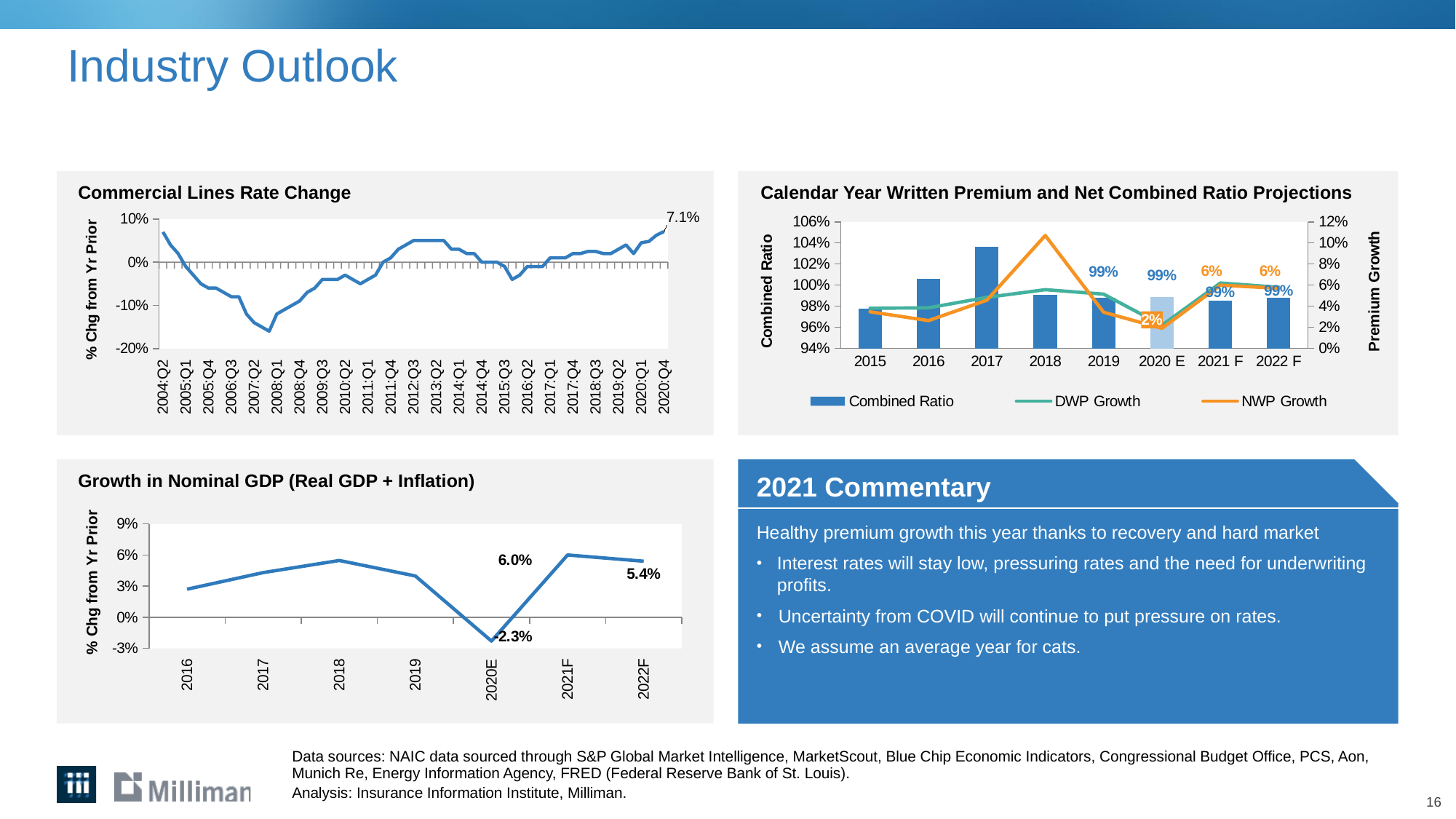
In the Growth in Nominal GDP chart, what is the value for 2020E? -2.3% How many series does the legend list in the Calendar Year Written Premium and Net Combined Ratio Projections chart? 3 In the Calendar Year Written Premium and Net Combined Ratio Projections chart, is the Combined Ratio for 2017 greater or less than 102%? greater In the Calendar Year Written Premium and Net Combined Ratio Projections chart, which year has the highest Combined Ratio bar? 2017 In the Growth in Nominal GDP chart, what is the difference between the 2021F and 2022F values? 0.6% In the Growth in Nominal GDP chart, what is the value for 2022F? 5.4% What kind of chart is the Growth in Nominal GDP (Real GDP + Inflation) chart? line chart In the Growth in Nominal GDP chart, what is the value for 2021F? 6.0% In the Calendar Year Written Premium and Net Combined Ratio Projections chart, what is the labeled NWP Growth value for 2020 E? 2% In the Growth in Nominal GDP chart, which year has the lowest value? 2020E In the Commercial Lines Rate Change chart, what is the labeled value for 2020:Q4? 7.1% How many years are plotted in the Growth in Nominal GDP chart? 7